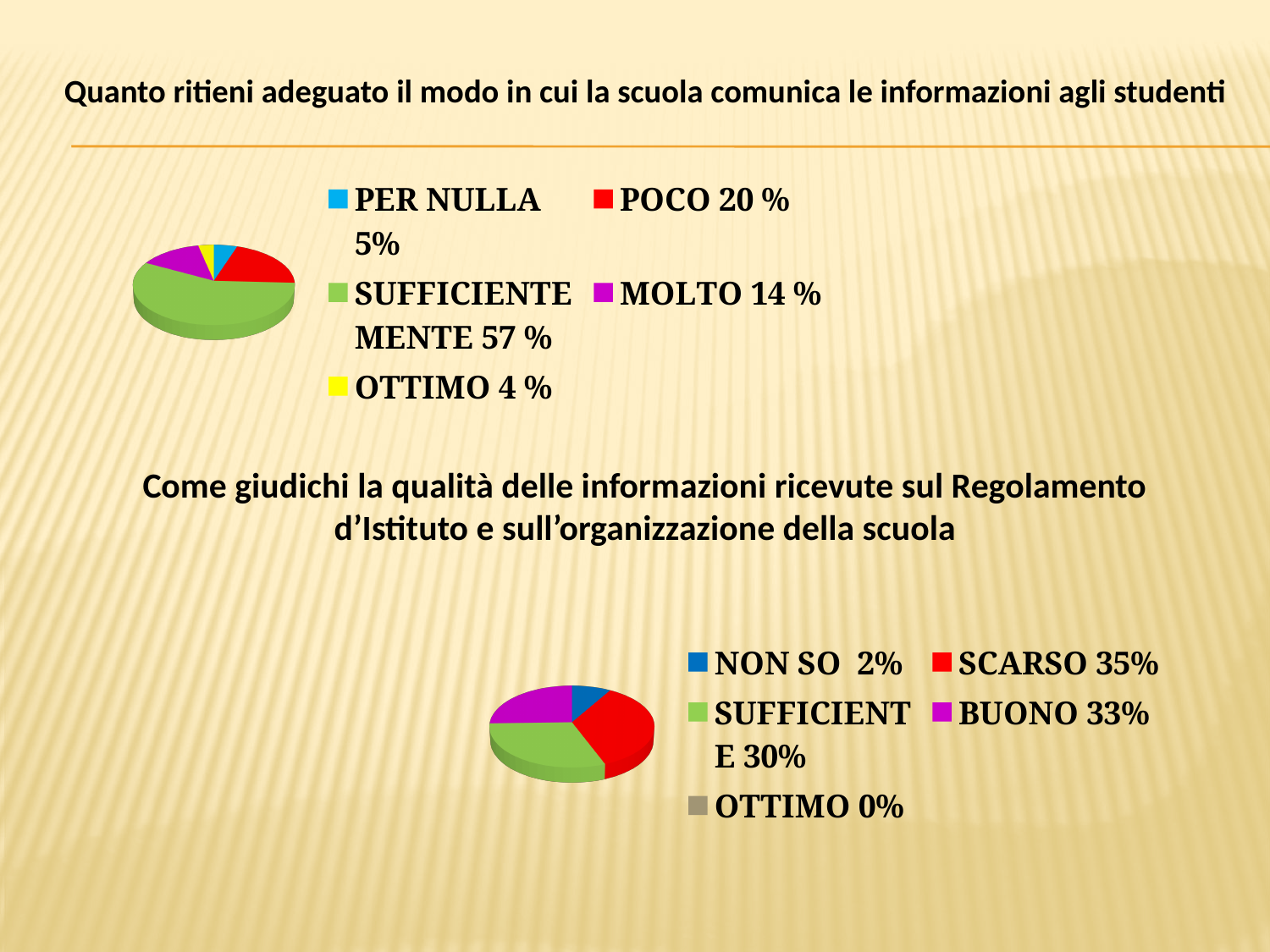
In the bottom chart (Come giudichi la qualità delle informazioni ricevute sul Regolamento d'Istituto), what percentage is shown for OTTIMO? 0% In the top chart (Quanto ritieni adeguato il modo in cui la scuola comunica le informazioni agli studenti), what percentage is shown for SUFFICIENTEMENTE? 57 % In the top chart (Quanto ritieni adeguato il modo in cui la scuola comunica le informazioni agli studenti), what is the difference in percentage points between POCO and PER NULLA? 15 In the bottom chart (Come giudichi la qualità delle informazioni ricevute sul Regolamento d'Istituto), what is the difference in percentage points between SCARSO and NON SO? 33 In the top chart (Quanto ritieni adeguato il modo in cui la scuola comunica le informazioni agli studenti), which category has the smallest share? OTTIMO In the top chart (Quanto ritieni adeguato il modo in cui la scuola comunica le informazioni agli studenti), what percentage is shown for MOLTO? 14 % What kind of chart is the bottom chart (Come giudichi la qualità delle informazioni ricevute sul Regolamento d'Istituto)? Pie chart In the top chart (Quanto ritieni adeguato il modo in cui la scuola comunica le informazioni agli studenti), how many categories does the legend list? 5 In the top chart (Quanto ritieni adeguato il modo in cui la scuola comunica le informazioni agli studenti), which category has the largest share? SUFFICIENTEMENTE In the bottom chart (Come giudichi la qualità delle informazioni ricevute sul Regolamento d'Istituto), what percentage is shown for SCARSO? 35% In the bottom chart (Come giudichi la qualità delle informazioni ricevute sul Regolamento d'Istituto), what colour represents SCARSO? Red